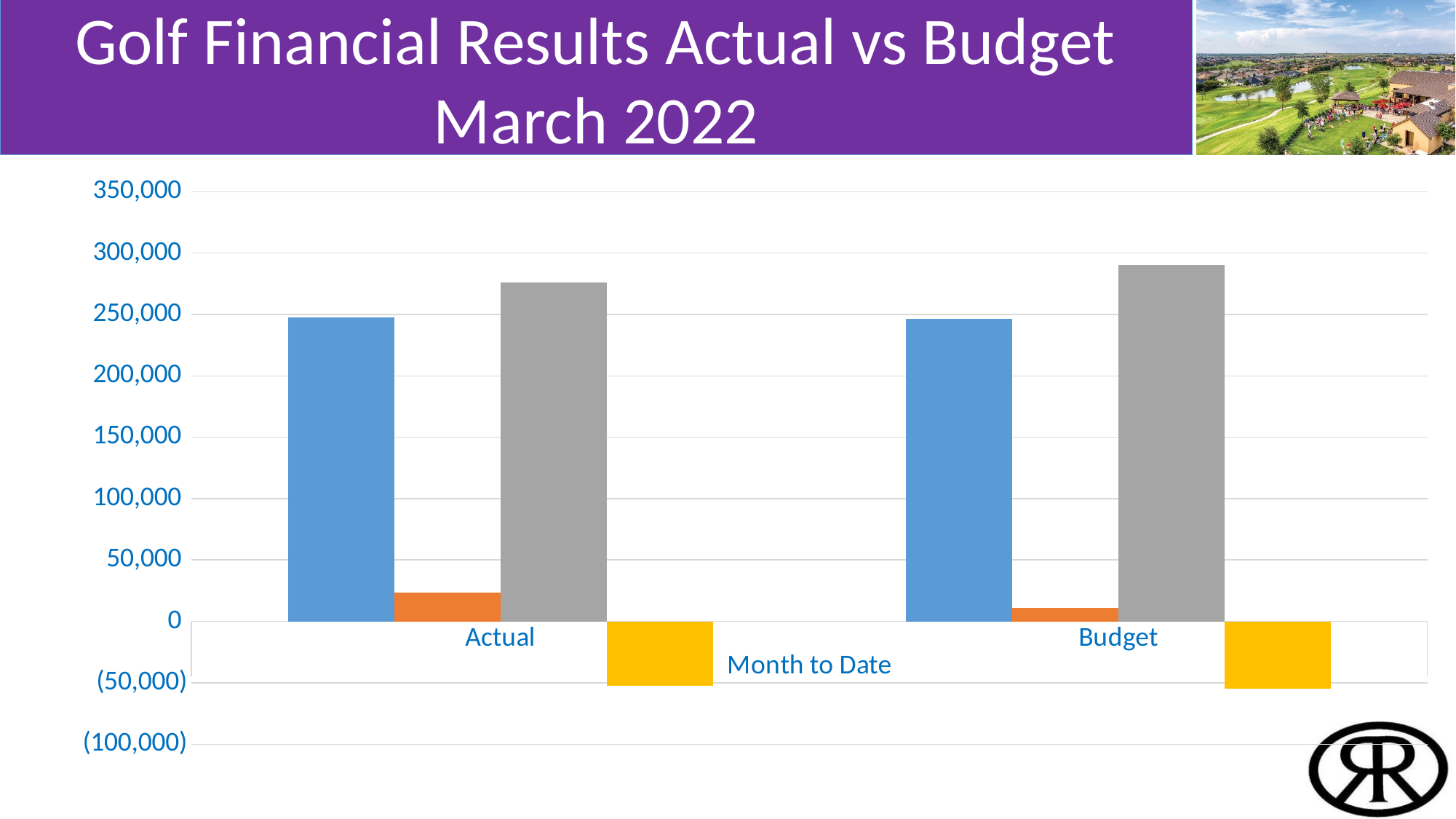
Is the value of the yellow bar for Budget greater or less than 0? less What is the title of the chart on the slide? Golf Financial Results Actual vs Budget March 2022 Is the value of the blue bar for Actual greater or less than 200,000? greater Which is larger, the gray bar for Actual or the gray bar for Budget? Budget Which is larger, the orange bar for Actual or the orange bar for Budget? Actual Is the value of the orange bar for Actual greater or less than 50,000? less How many categories are shown on the x axis of the chart? 2 What are the two categories on the x axis of the chart? Actual and Budget What kind of chart is shown on the slide? bar chart